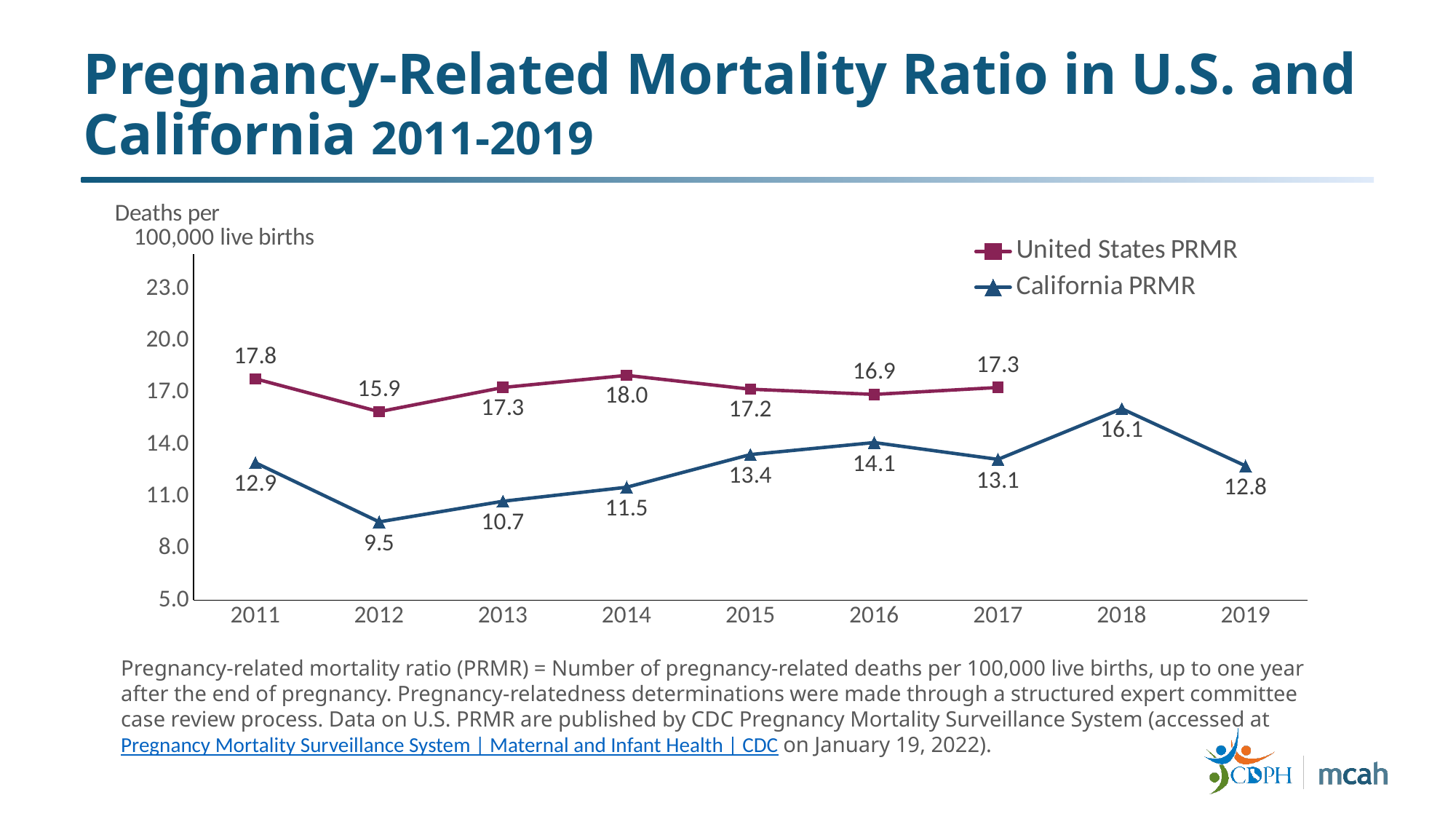
How many years are shown on the x axis? 9 What is the label on the y axis? Deaths per 100,000 live births What was the California PRMR in 2018? 16.1 Which was higher in 2016, the United States PRMR or the California PRMR? United States PRMR What was the United States PRMR in 2014? 18.0 What was the California PRMR in 2012? 9.5 What kind of chart is shown on the slide? Line chart In which year was the United States PRMR lowest? 2012 Did the California PRMR rise or fall from 2018 to 2019? Fall How many series does the legend list? 2 What is the difference between the United States PRMR and the California PRMR in 2011? 4.9 In which year was the California PRMR highest? 2018